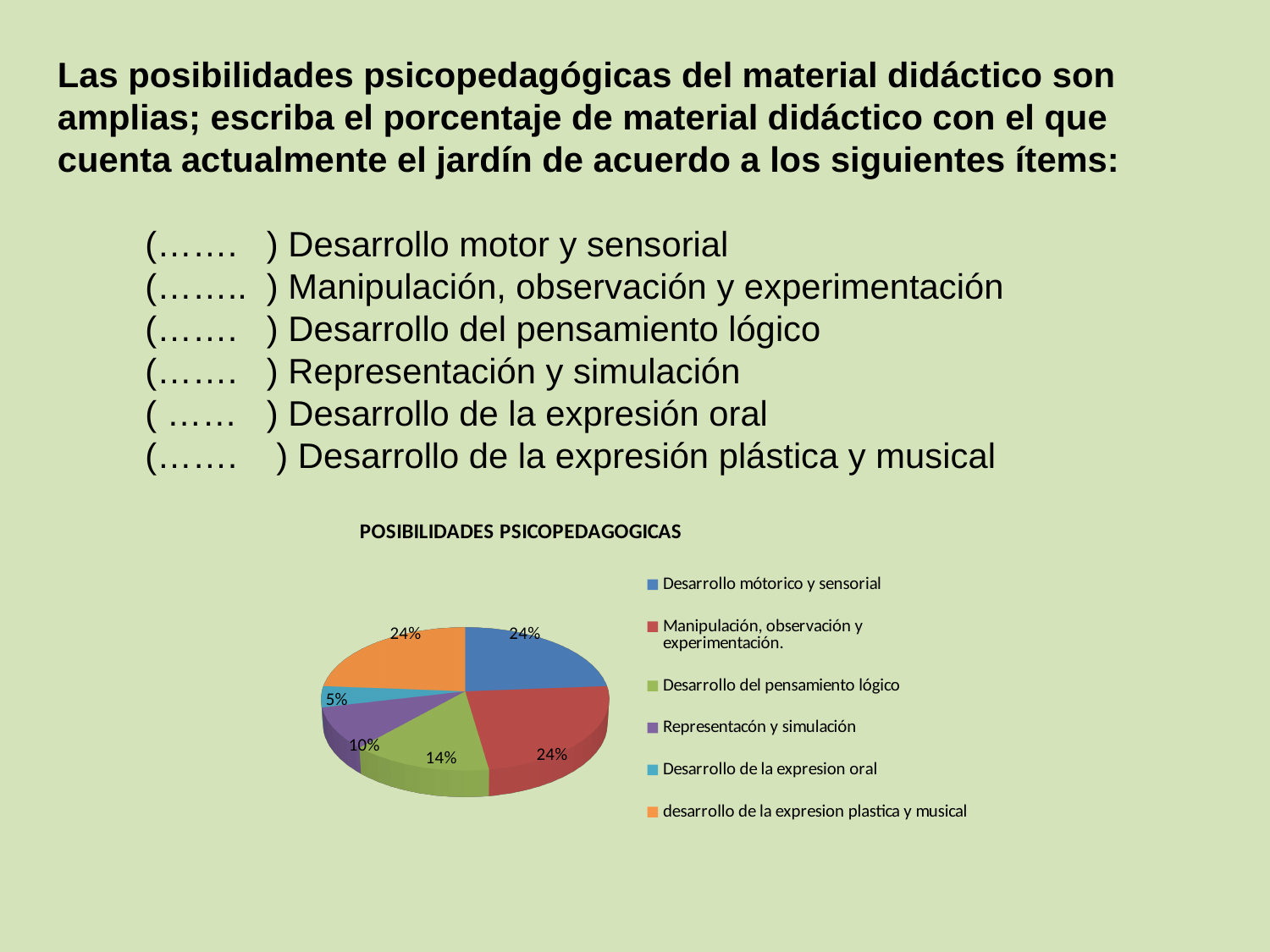
What percentage is shown for Representacón y simulación? 10% How many entries does the chart legend list? 6 What percentage is shown for Desarrollo del pensamiento lógico? 14% What is the difference between the percentages for Desarrollo del pensamiento lógico and Representacón y simulación? 4% How many slices does the pie chart have? 6 What colour is the slice for desarrollo de la expresion plastica y musical? orange Which category has the smallest slice of the pie? Desarrollo de la expresion oral What percentage is shown for Desarrollo mótorico y sensorial? 24% What is the title of the chart? POSIBILIDADES PSICOPEDAGOGICAS Which is larger, the slice for Manipulación, observación y experimentación or the slice for Desarrollo del pensamiento lógico? Manipulación, observación y experimentación What percentage is shown for Desarrollo de la expresion oral? 5% What kind of chart is shown on the slide? pie chart